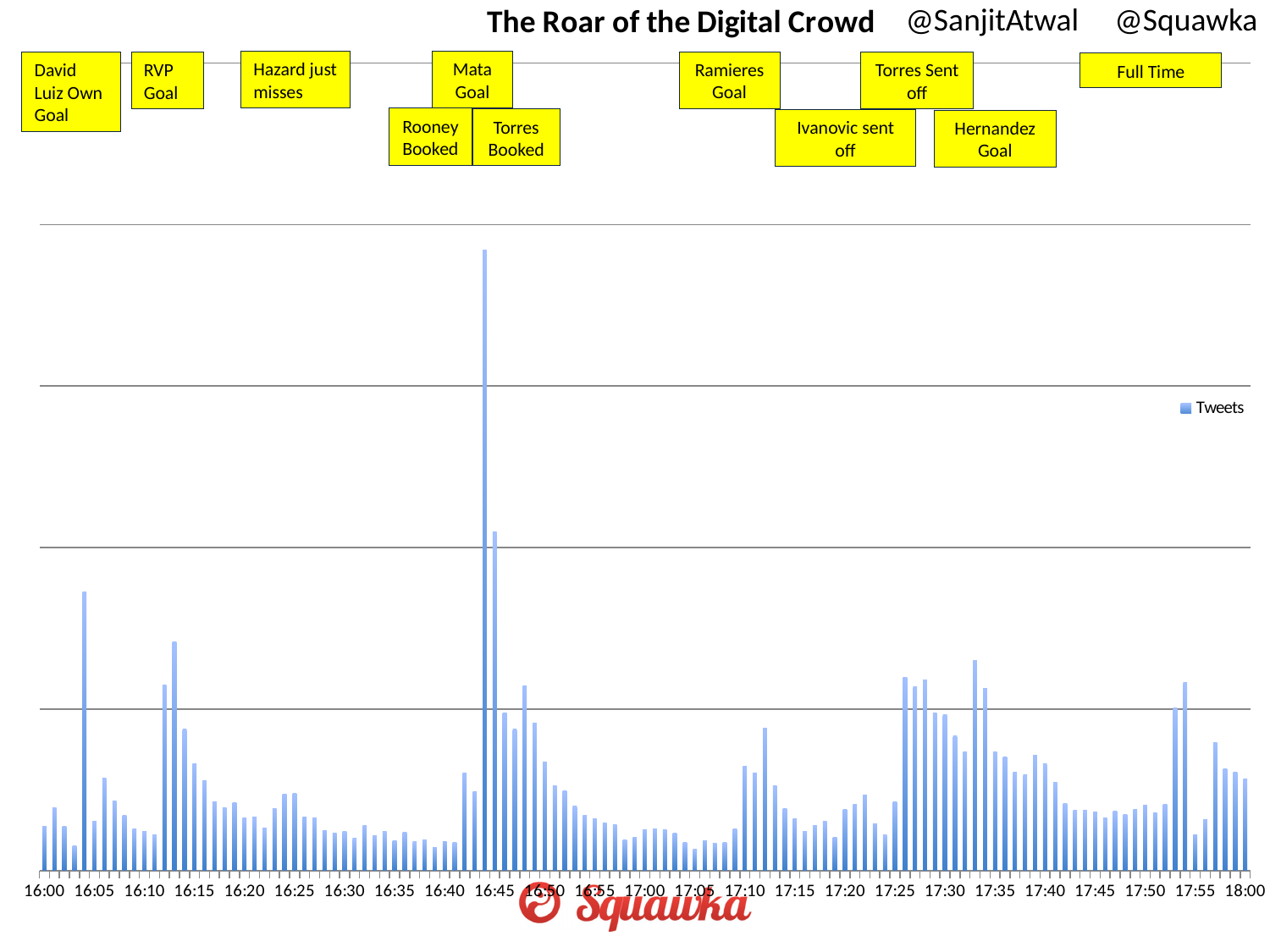
Which is larger, the number of tweets at 17:55 or at 17:05? 17:55 What is the last time label on the x axis? 18:00 How many time labels are shown along the x axis? 25 What is the first time label on the x axis? 16:00 What is the name of the series shown in the legend? Tweets What is the title of the chart? The Roar of the Digital Crowd Which is larger, the number of tweets at 17:30 or at 17:05? 17:30 Which is larger, the number of tweets at 16:45 or at 17:00? 16:45 What kind of chart is shown on the slide? bar chart Which event annotation sits above the tallest bar in the chart? Mata Goal How many series does the legend list? 1